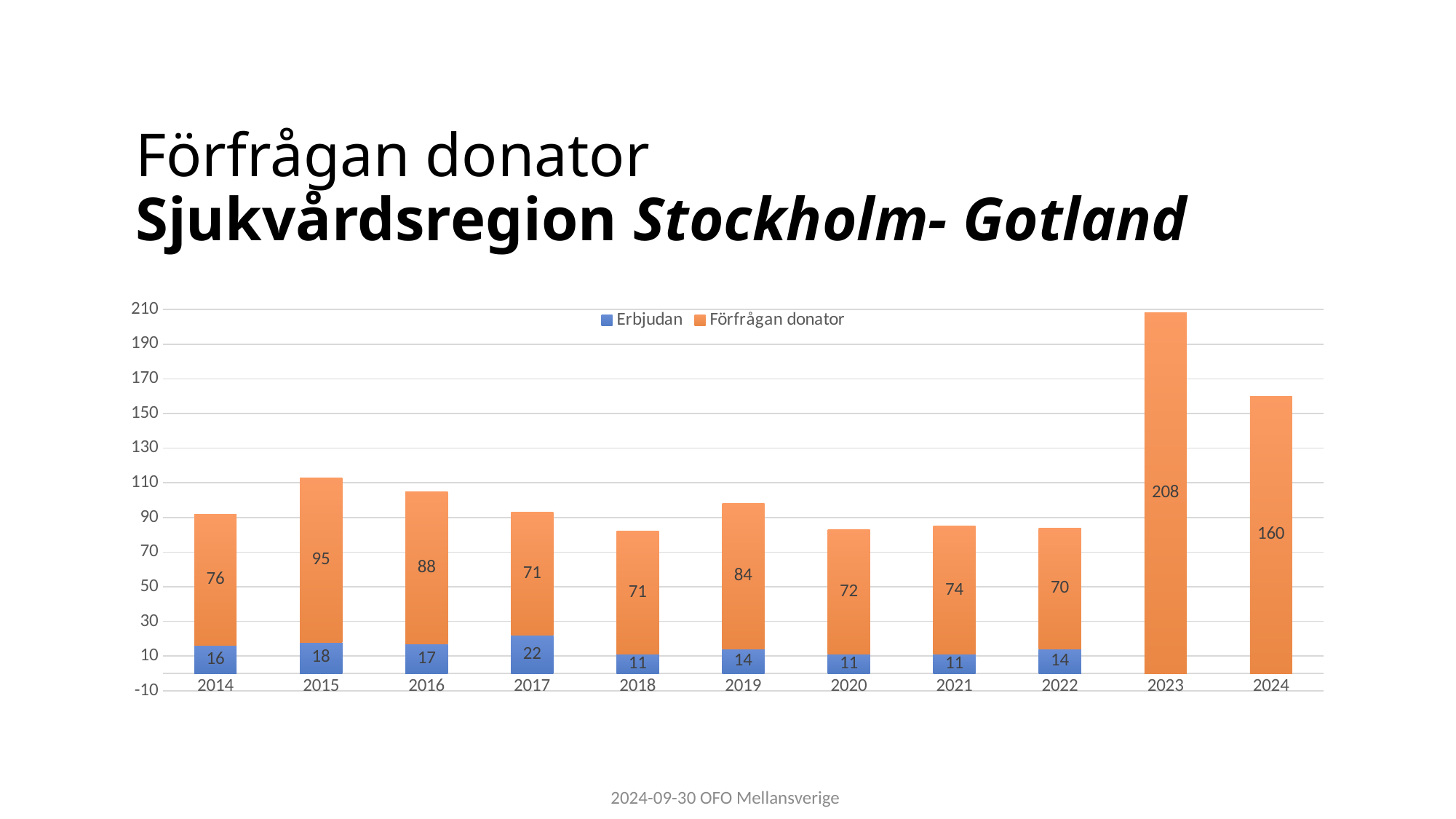
What kind of chart is shown on the slide? Stacked bar chart What is the value of Erbjudan for 2017? 22 Which year has the highest value for Förfrågan donator? 2023 What is the value of Förfrågan donator for 2024? 160 Which year has the highest value for Erbjudan? 2017 How many years are shown on the x axis? 11 Which year has the lowest value for Förfrågan donator? 2022 What is the total of the stacked bar for 2015? 113 How many series does the legend list? 2 What is the value of Förfrågan donator for 2015? 95 What is the difference between the Förfrågan donator values for 2023 and 2024? 48 Which is larger, the Förfrågan donator value for 2016 or for 2019? 2016